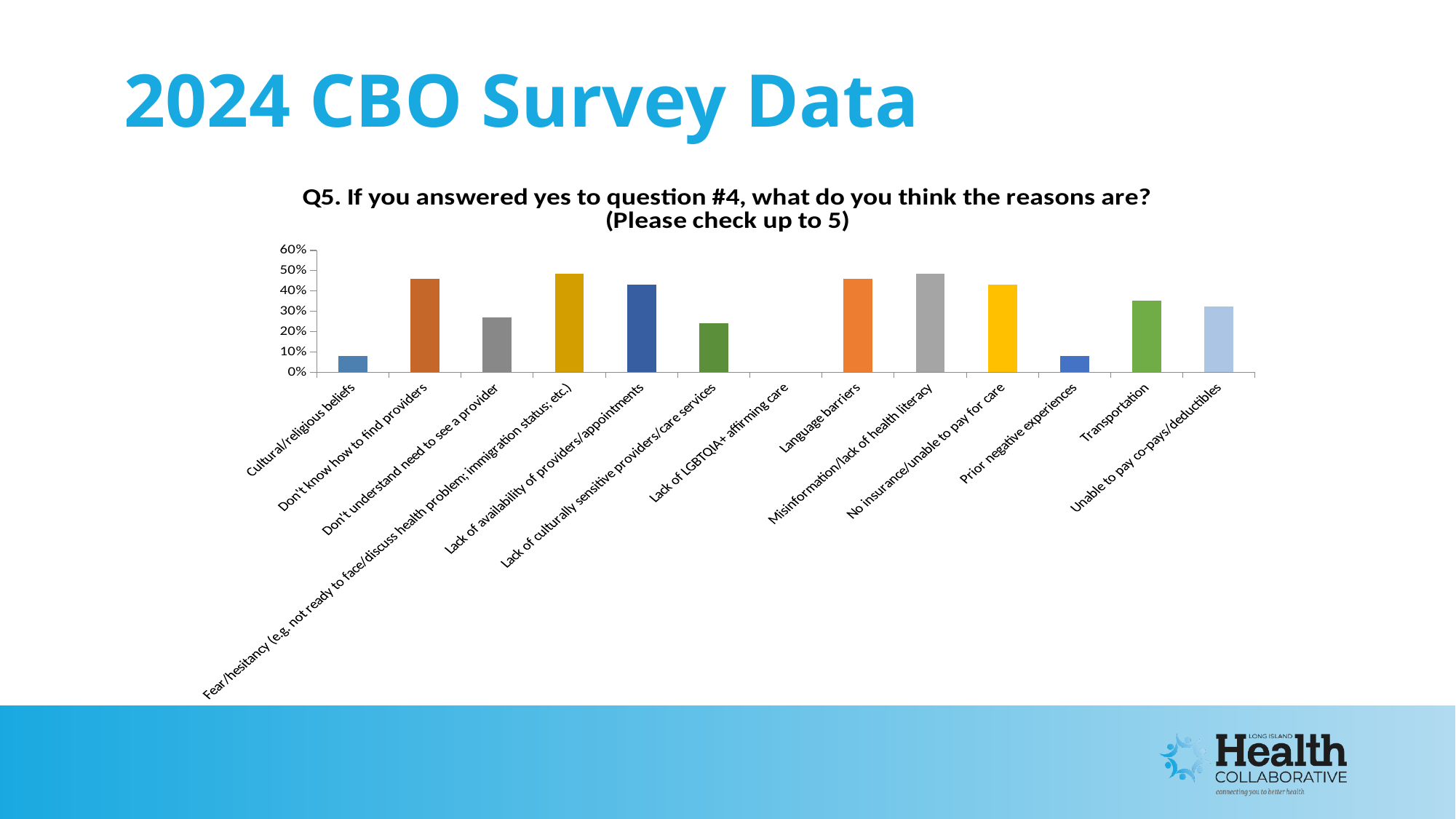
How many categories are shown on the x axis of the chart? 13 Is the value for Don't understand need to see a provider greater or less than 30%? less Is the value for Misinformation/lack of health literacy greater or less than 40%? greater Is the value for Cultural/religious beliefs greater or less than 10%? less What is the highest value shown on the y axis of the chart? 60% Which category has the lowest value in the chart? Lack of LGBTQIA+ affirming care Which is larger, the value for Don't know how to find providers or the value for Don't understand need to see a provider? Don't know how to find providers Which is larger, the value for Prior negative experiences or the value for Transportation? Transportation What kind of chart is shown on the slide? bar chart